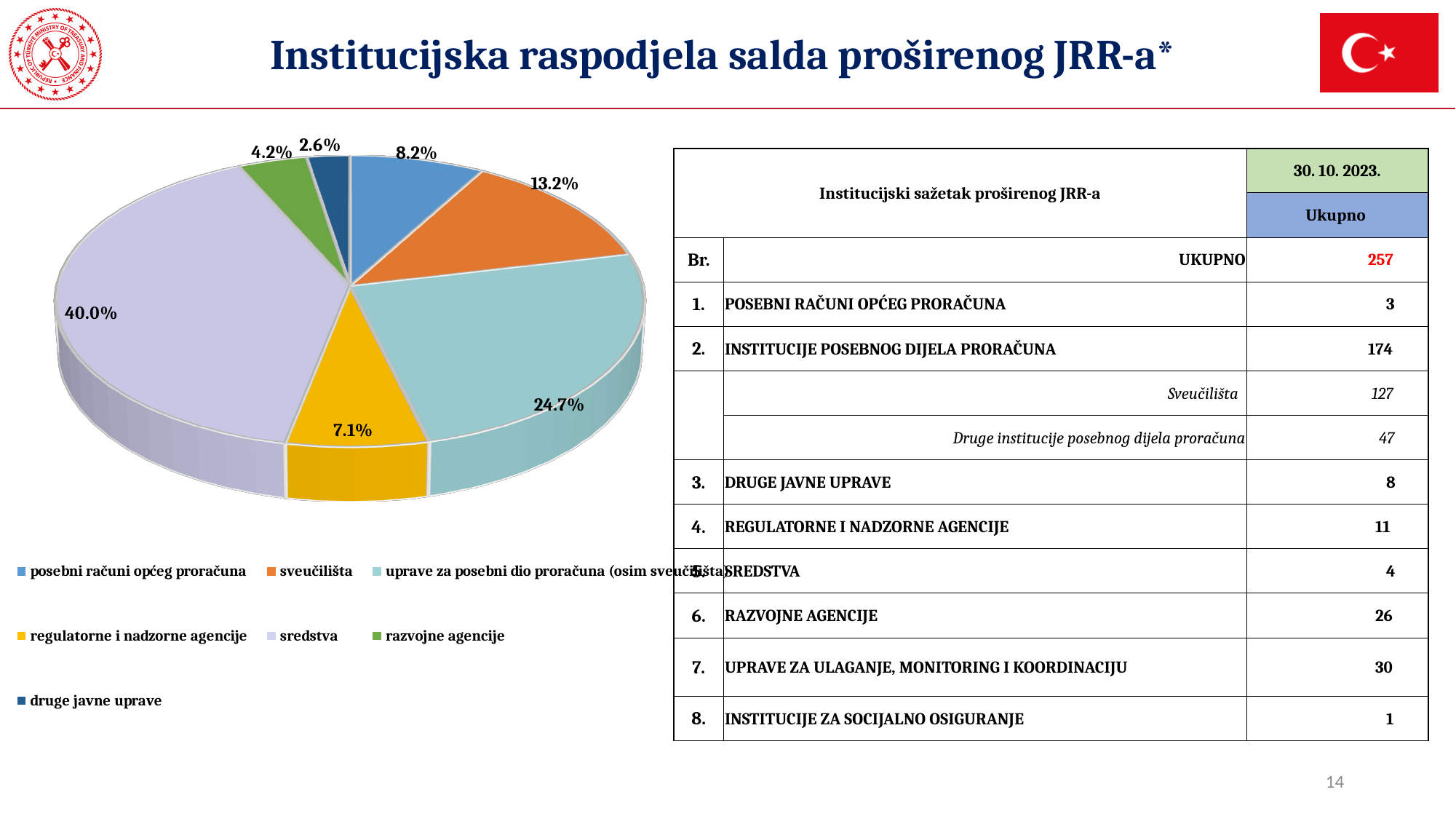
What is the difference between the 'sredstva' slice and the 'sveučilišta' slice in the pie chart? 26.8% What kind of chart is shown on the left of the slide? pie chart What colour is the 'sredstva' slice in the pie chart? light purple (lavender) Which category has the largest slice in the pie chart? sredstva What is the value shown for 'posebni računi općeg proračuna' in the pie chart? 8.2% Which category has the smallest slice in the pie chart? druge javne uprave Which is larger in the pie chart: 'posebni računi općeg proračuna' or 'regulatorne i nadzorne agencije'? posebni računi općeg proračuna What share of the pie chart does the 'sredstva' slice represent? 40.0% What is the value shown for 'sveučilišta' in the pie chart? 13.2% How many slices does the pie chart have? 7 What is the value shown for 'regulatorne i nadzorne agencije' in the pie chart? 7.1% What is the value shown for 'razvojne agencije' in the pie chart? 4.2%